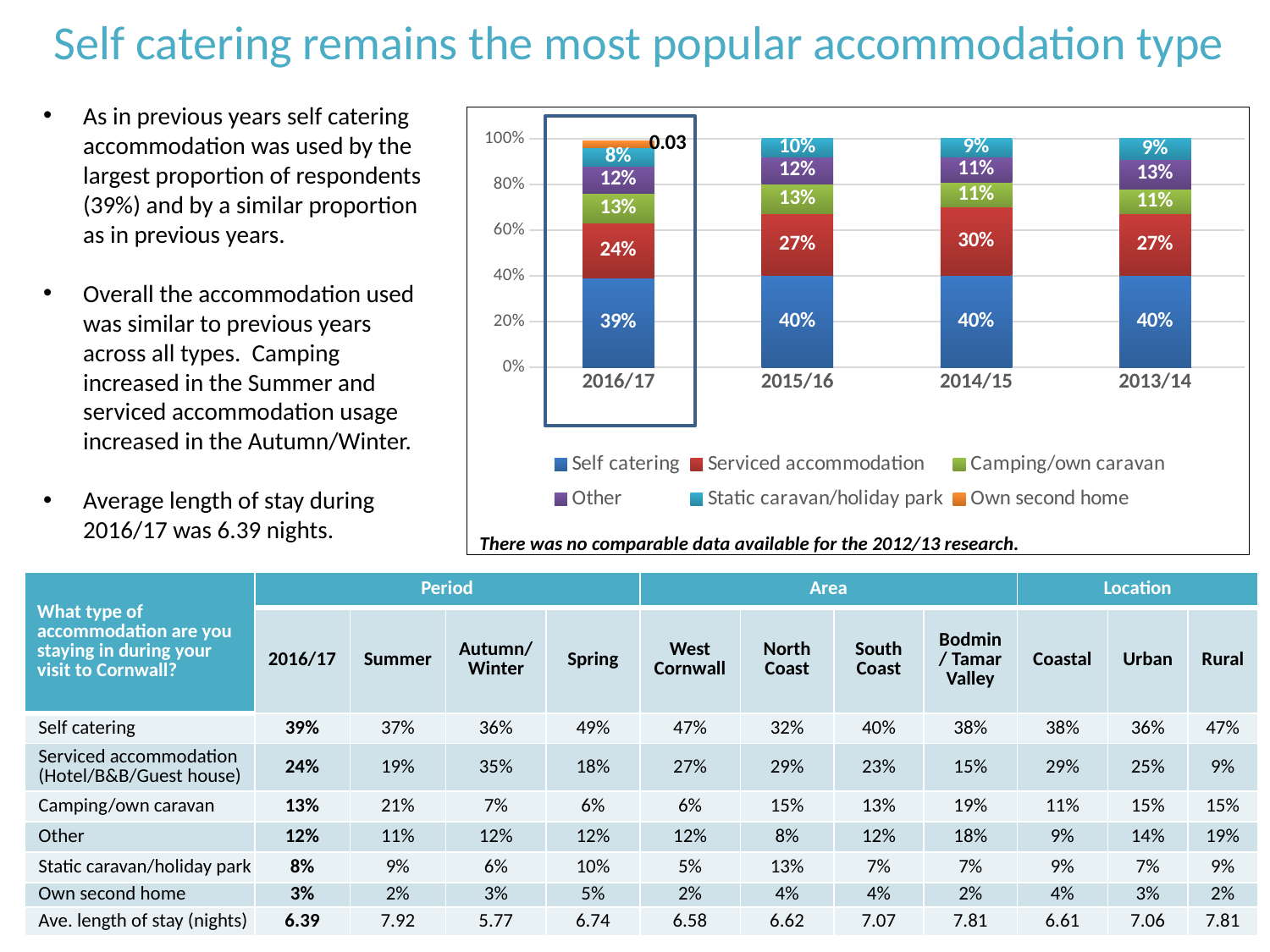
What was the share of serviced accommodation in 2014/15? 30% Which year's bar is highlighted with a box outline on the chart? 2016/17 Which year had a larger camping/own caravan share, 2016/17 or 2014/15? 2016/17 How many percentage points higher was serviced accommodation in 2014/15 than in 2016/17? 6 percentage points How many accommodation types does the chart legend list? 6 In which year was the serviced accommodation share the highest? 2014/15 What type of chart is used to show accommodation type by year? Stacked bar chart What percentage of respondents used self catering accommodation in 2016/17? 39% What is the value for 'Other' accommodation in 2013/14? 13% In which year was the self catering share the lowest? 2016/17 How many years are shown on the x axis of the chart? 4 What percentage is shown for static caravan/holiday park in 2015/16? 10%